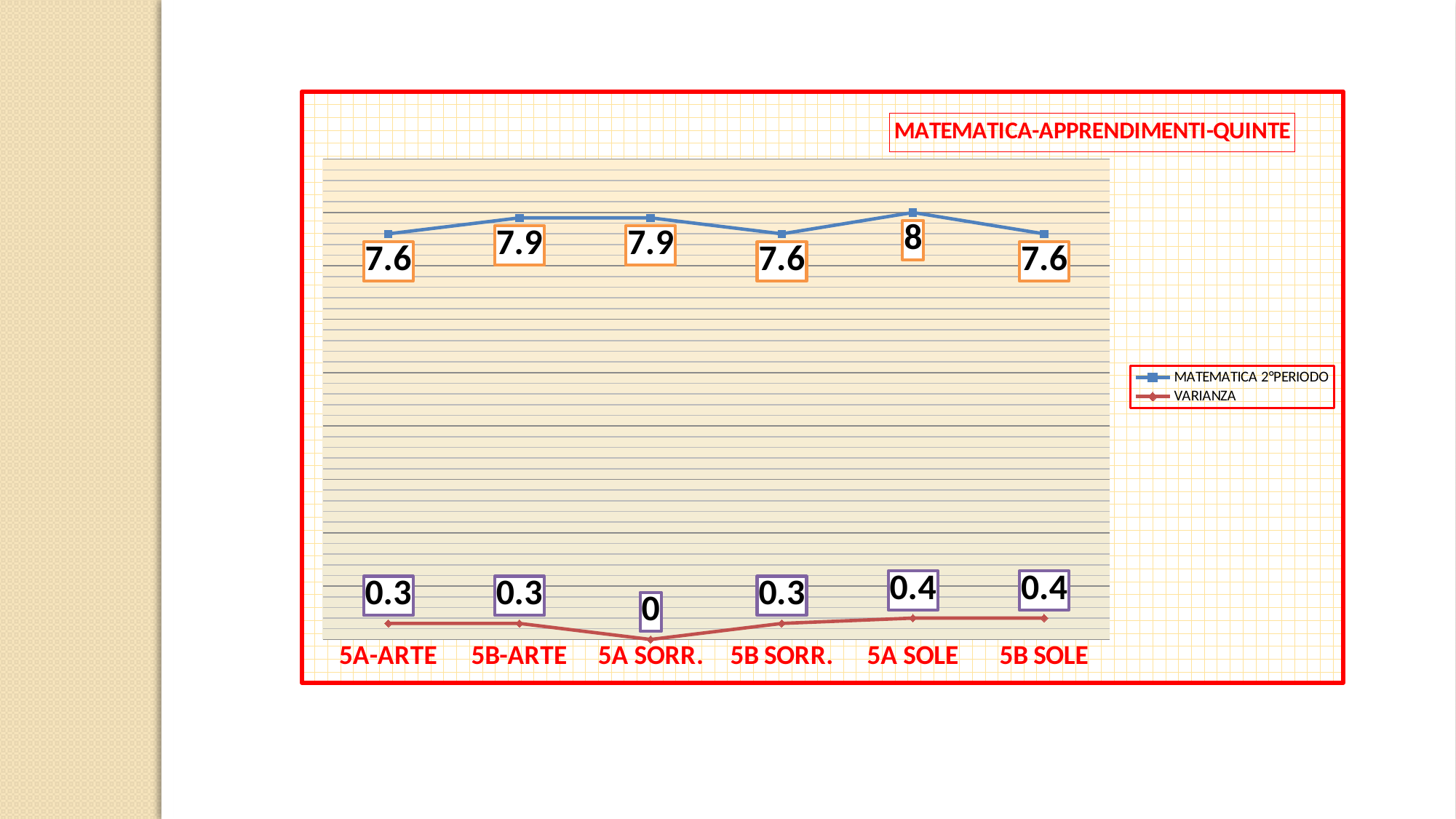
What is the MATEMATICA 2°PERIODO value for 5B-ARTE? 7.9 What is the title of the chart? MATEMATICA-APPRENDIMENTI-QUINTE Which is larger, the MATEMATICA 2°PERIODO value for 5B-ARTE or for 5B SORR.? 5B-ARTE What kind of chart is shown? Line chart What is the VARIANZA value for 5A SORR.? 0 What is the difference between the MATEMATICA 2°PERIODO values for 5A SOLE and 5B SOLE? 0.4 What is the VARIANZA value for 5B SOLE? 0.4 Which category has the highest MATEMATICA 2°PERIODO value? 5A SOLE What is the MATEMATICA 2°PERIODO value for 5A SOLE? 8 How many series does the legend list? 2 Which category has the lowest VARIANZA value? 5A SORR. How many categories are shown on the x axis? 6